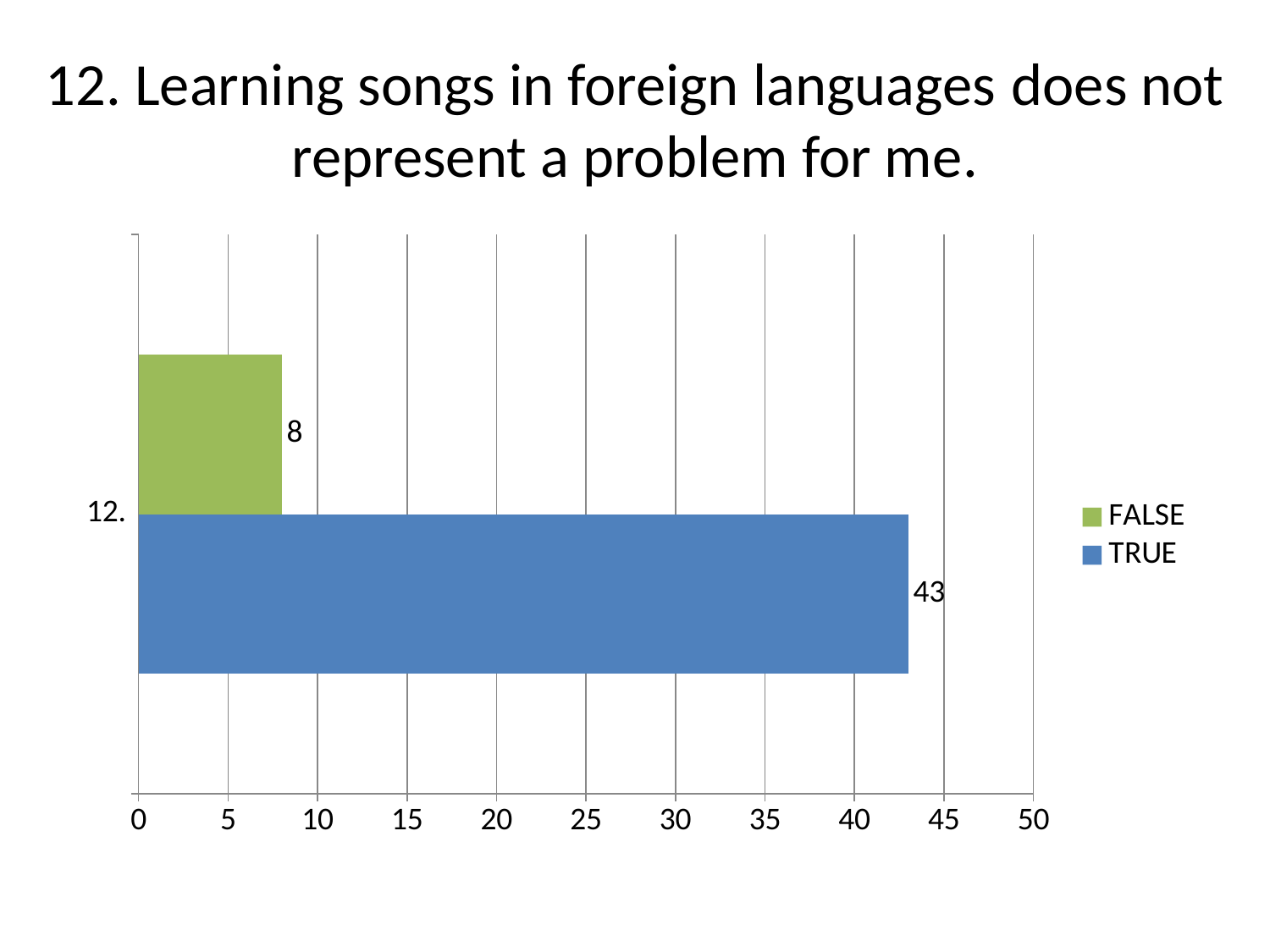
What colour is the bar for TRUE? blue What is the difference between the TRUE and FALSE values? 35 What is the value for FALSE? 8 Which series has the higher value, TRUE or FALSE? TRUE Is the value for TRUE greater or less than 40? greater How many series does the legend list? 2 What is the value for TRUE? 43 What kind of chart is shown on the slide? bar chart What is the combined total of the TRUE and FALSE values? 51 Is the value for FALSE greater or less than 10? less What is the maximum value shown on the horizontal axis? 50 Which series has the lowest value? FALSE